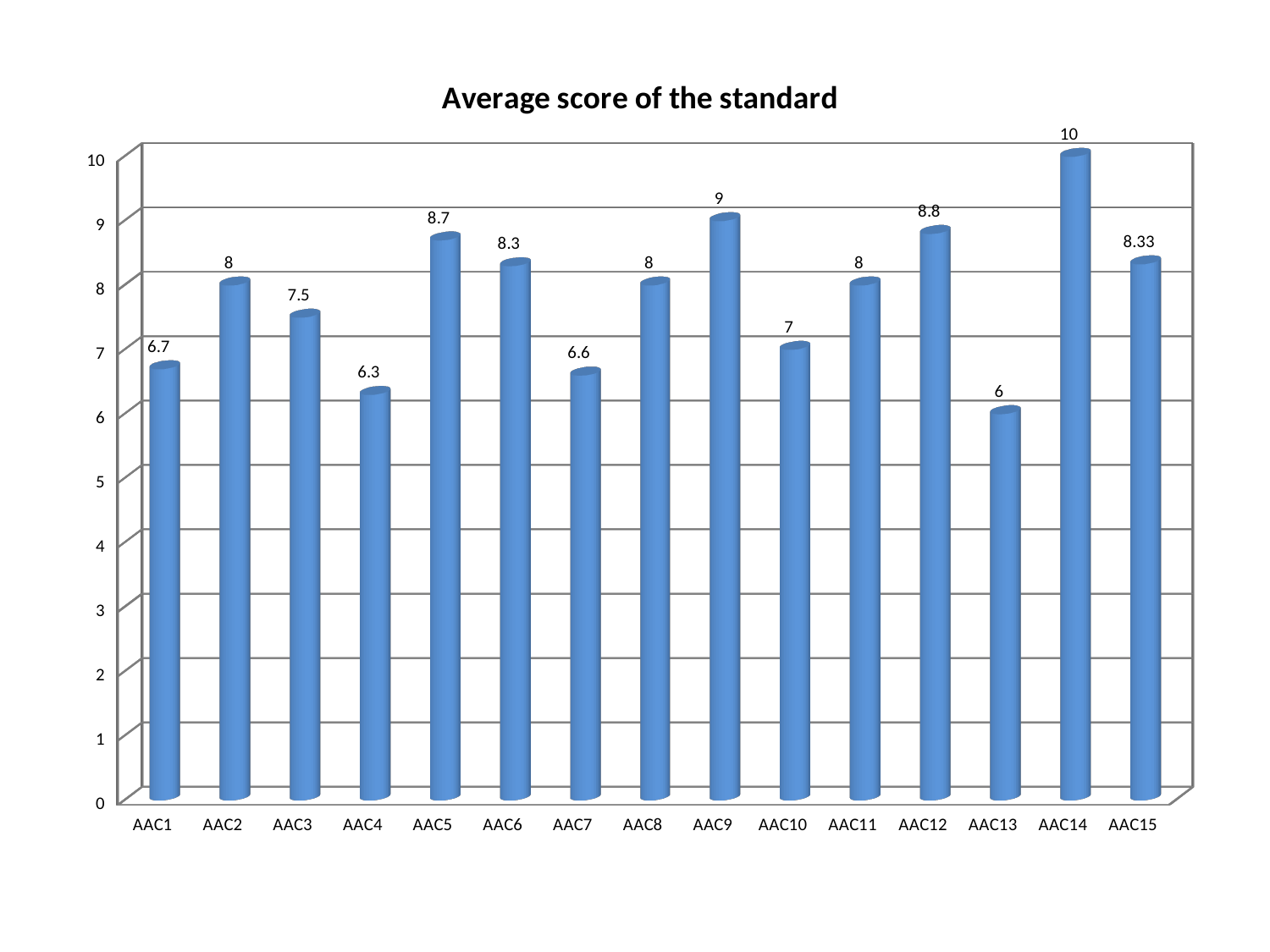
Is the value for AAC4 greater or less than 7? less What is the title of the chart? Average score of the standard What kind of chart is shown on the slide? Bar chart What is the difference between the average scores of AAC9 and AAC1? 2.3 Which category has the lowest average score? AAC13 Which has a higher average score, AAC12 or AAC6? AAC12 What is the average score for AAC15? 8.33 How many categories are shown on the x axis? 15 What is the average score for AAC13? 6 What is the average score for AAC5? 8.7 Which category has the highest average score? AAC14 What is the difference between the average scores of AAC14 and AAC13? 4